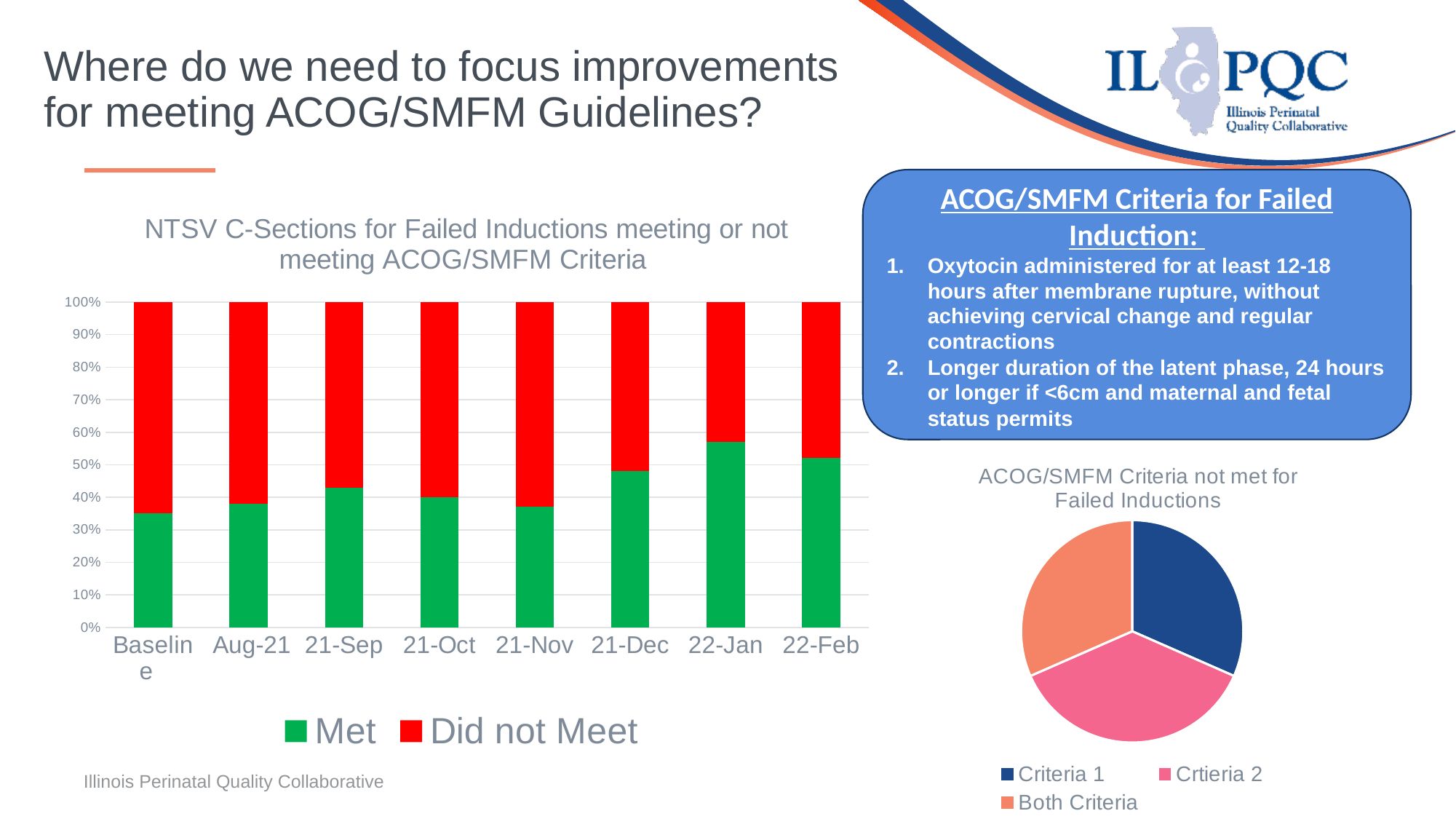
In the 'NTSV C-Sections for Failed Inductions' bar chart, how many time periods are shown on the x axis? 8 What kind of chart is the 'ACOG/SMFM Criteria not met for Failed Inductions' chart? Pie chart In the 'NTSV C-Sections for Failed Inductions' bar chart, which colour represents the 'Did not Meet' series? Red What kind of chart is the 'NTSV C-Sections for Failed Inductions meeting or not meeting ACOG/SMFM Criteria' chart? Stacked bar chart In the 'NTSV C-Sections for Failed Inductions' bar chart, which period has the highest 'Met' share? 22-Jan In the 'NTSV C-Sections for Failed Inductions' bar chart, is the 'Met' share for 22-Jan greater or less than 50%? greater In the 'NTSV C-Sections for Failed Inductions' bar chart, is the 'Met' share for Baseline greater or less than 40%? less In the 'NTSV C-Sections for Failed Inductions' bar chart, how many series does the legend list? 2 In the 'NTSV C-Sections for Failed Inductions' bar chart, which has the larger 'Did not Meet' share, Baseline or 22-Jan? Baseline In the 'ACOG/SMFM Criteria not met for Failed Inductions' pie chart, how many slices are there? 3 In the 'NTSV C-Sections for Failed Inductions' bar chart, is the 'Met' share for 21-Dec greater or less than 40%? greater In the 'NTSV C-Sections for Failed Inductions' bar chart, which has the larger 'Met' share, Baseline or 22-Feb? 22-Feb